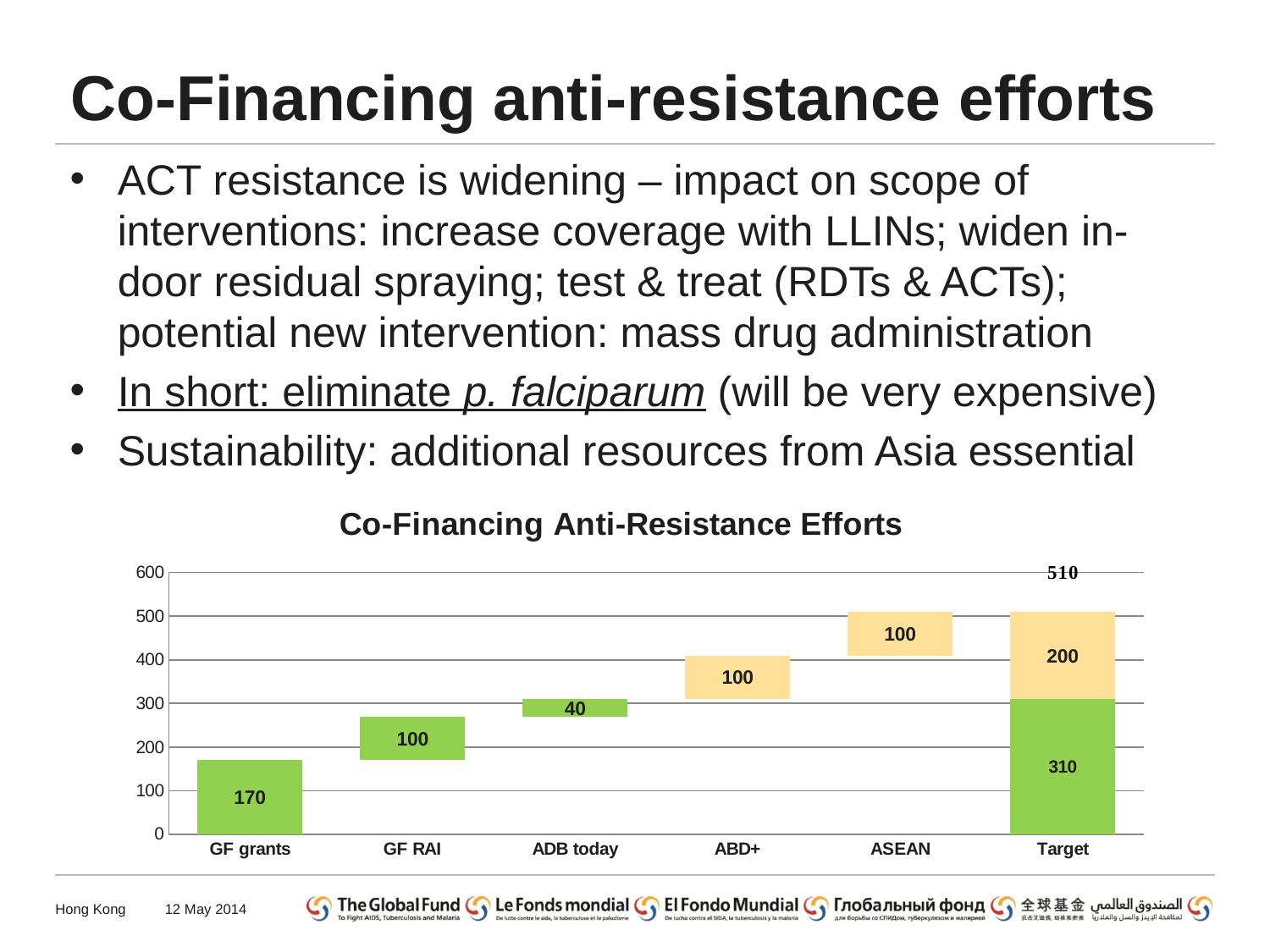
What is the value labelled on the ASEAN bar? 100 What is the value labelled on the GF grants bar? 170 What is the total shown above the Target bar? 510 What value is labelled on the green segment of the Target bar? 310 What type of chart is shown on the slide? Bar chart How many categories are shown on the x axis? 6 Which is larger, the value for GF grants or the value for ADB today? GF grants What is the value labelled on the ADB today bar? 40 What value is labelled on the yellow segment of the Target bar? 200 Which category has the smallest labelled value? ADB today What is the title of the chart? Co-Financing Anti-Resistance Efforts What is the difference between the GF grants value and the GF RAI value? 70